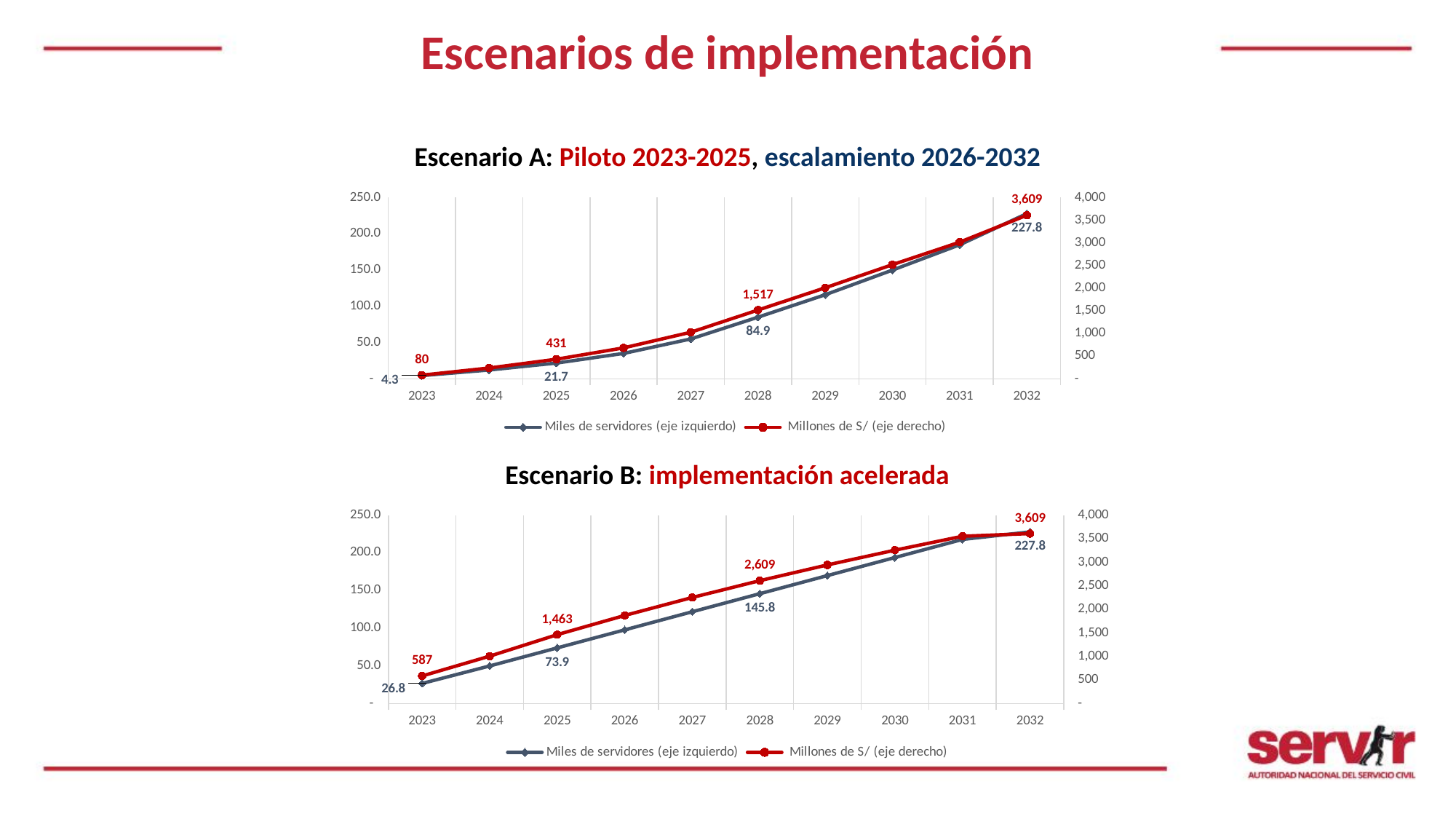
In the Escenario A chart, what is the value of Miles de servidores in 2025? 21.7 In the Escenario A chart, what is the difference between the Miles de servidores values in 2032 and 2028? 142.9 In the Escenario A chart, is the Miles de servidores value in 2030 greater or less than 100.0? greater In the Escenario B chart, what is the value of Millones de S/ in 2025? 1,463 In the Escenario B chart, what is the value of Miles de servidores in 2023? 26.8 What type of chart is used for Escenario B? Line chart How many series does the legend of the Escenario B chart list? 2 How many years are shown on the x axis of the Escenario A chart? 10 In the Escenario B chart, what is the difference between the Millones de S/ values in 2028 and 2023? 2,022 In the Escenario A chart, what is the value of Millones de S/ in 2028? 1,517 Which chart shows a higher Millones de S/ value in 2025, Escenario A or Escenario B? Escenario B